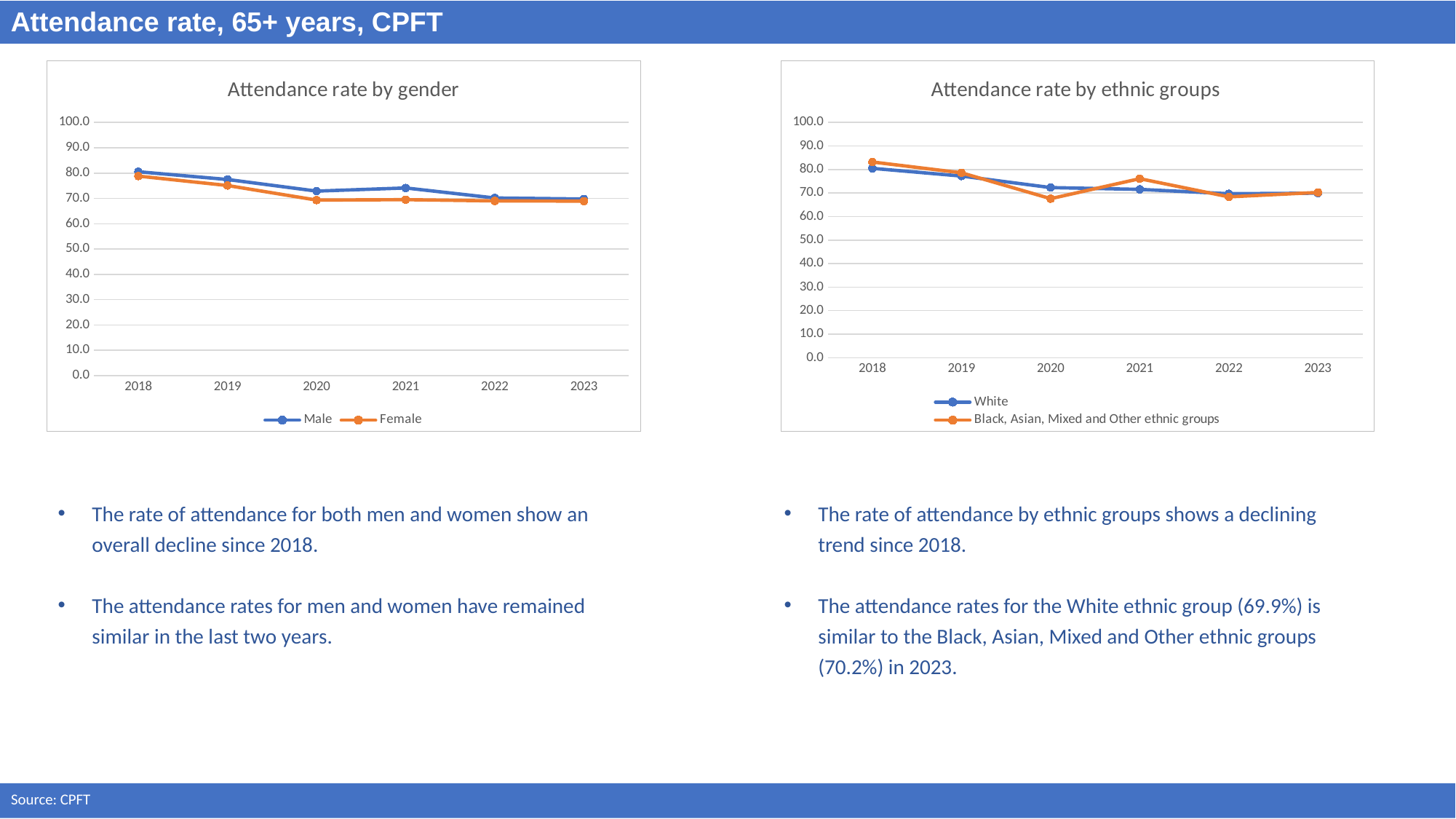
How many series does the legend of the 'Attendance rate by ethnic groups' chart list? 2 In the 'Attendance rate by gender' chart, is the Male value for 2021 greater or less than 70.0? greater In the 'Attendance rate by ethnic groups' chart, which series has the higher value in 2021? Black, Asian, Mixed and Other ethnic groups In the 'Attendance rate by gender' chart, do the Female values generally rise or fall from 2018 to 2023? fall What are the two series named in the legend of the 'Attendance rate by gender' chart? Male and Female In the 'Attendance rate by ethnic groups' chart, in which year is the value for Black, Asian, Mixed and Other ethnic groups highest? 2018 In the 'Attendance rate by ethnic groups' chart, is the 2018 value for Black, Asian, Mixed and Other ethnic groups greater or less than 80.0? greater In the 'Attendance rate by gender' chart, in which year is the Male value highest? 2018 In the 'Attendance rate by ethnic groups' chart, in which year is the value for Black, Asian, Mixed and Other ethnic groups lowest? 2020 In the 'Attendance rate by gender' chart, which series has the higher value in 2020, Male or Female? Male How many years are shown on the x axis of the 'Attendance rate by gender' chart? 6 What kind of chart is the 'Attendance rate by gender' chart? line chart